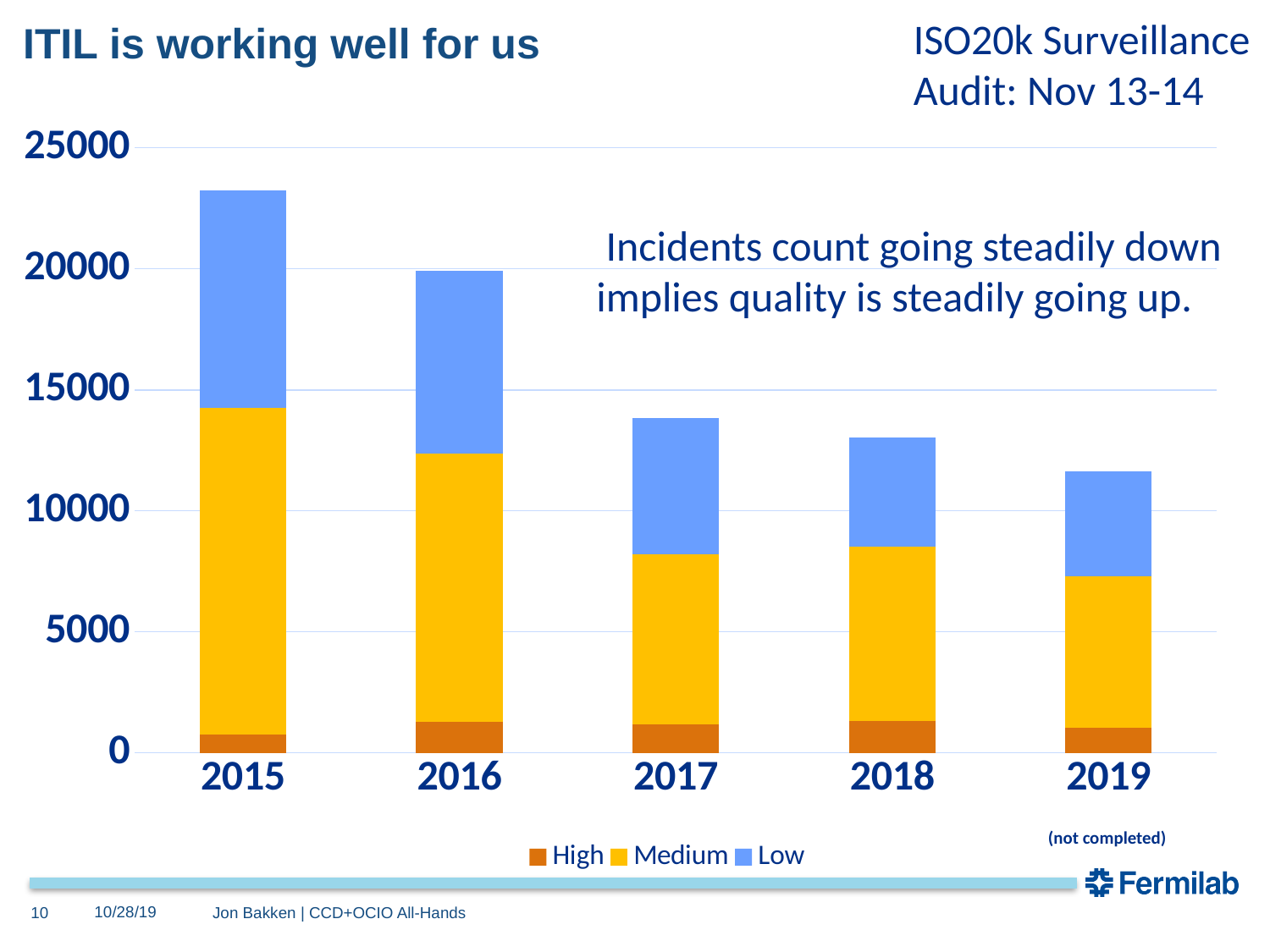
What kind of chart is shown on the slide? stacked bar chart Which year has the tallest stacked bar? 2015 Which year has the shortest stacked bar? 2019 How many years are shown on the x axis of the chart? 5 Is the total for 2015 greater or less than 20000? greater Is the total for 2017 greater or less than 15000? less Which series forms the bottom segment of each stacked bar? High How many series does the chart's legend list? 3 Which year has the larger total, 2016 or 2017? 2016 Which series is shown in blue in the legend? Low Do the total incident counts rise or fall from 2015 to 2019? fall Is the total for 2019 greater or less than 10000? greater